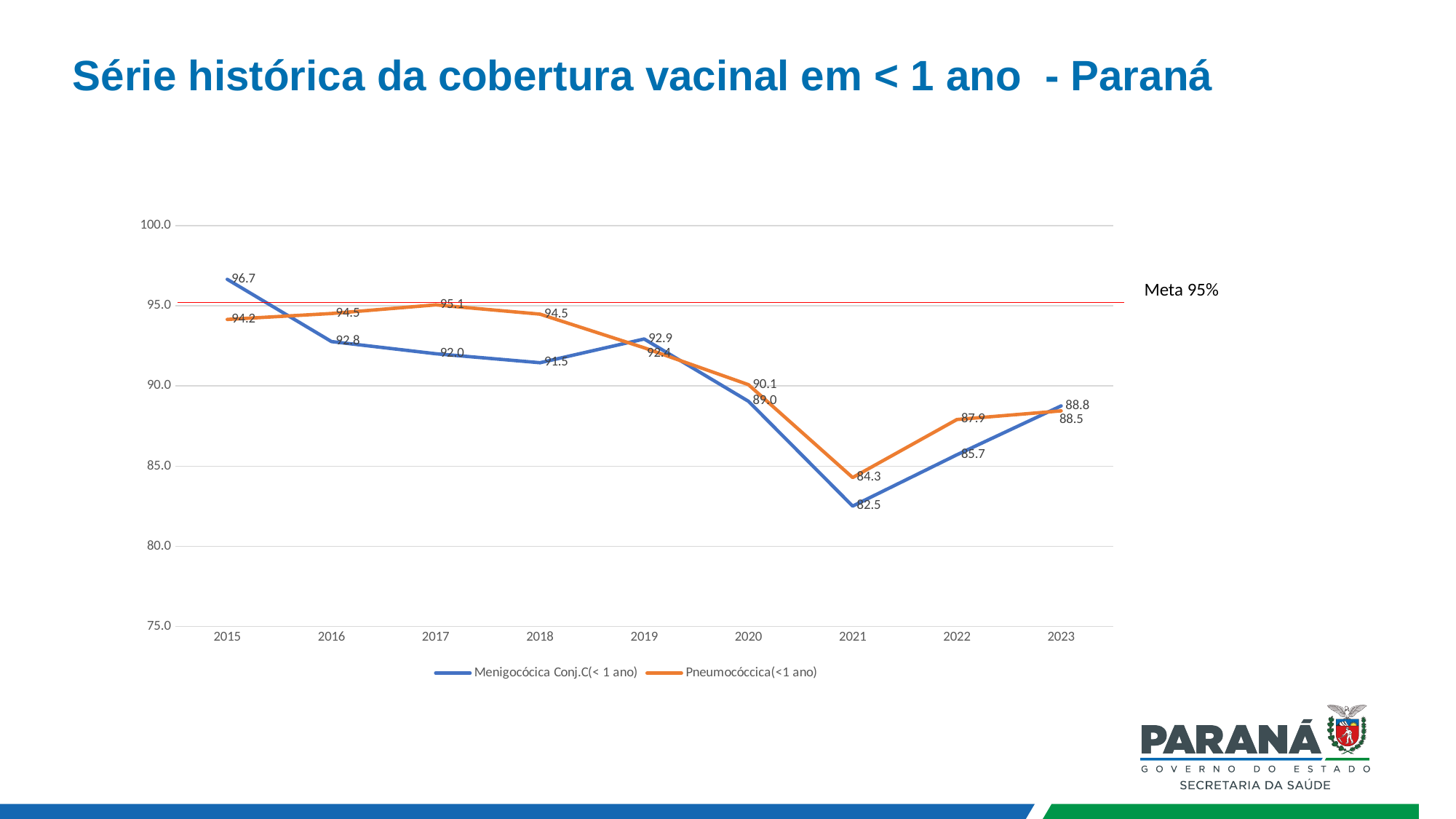
How many years are shown on the x axis? 9 What target (Meta) value is marked on the chart? 95% In which year is the Menigocócica Conj.C(< 1 ano) series at its lowest? 2021 What is the value for Menigocócica Conj.C(< 1 ano) in 2015? 96.7 What is the value for Pneumocóccica(<1 ano) in 2017? 95.1 What kind of chart is shown on the slide? Line chart What is the value for Menigocócica Conj.C(< 1 ano) in 2022? 85.7 How many series does the legend list? 2 Which series has the higher value in 2016, Menigocócica Conj.C(< 1 ano) or Pneumocóccica(<1 ano)? Pneumocóccica(<1 ano) In which year is the Pneumocóccica(<1 ano) series at its highest? 2017 What is the difference between the Pneumocóccica(<1 ano) and Menigocócica Conj.C(< 1 ano) values in 2021? 1.8 Does the Menigocócica Conj.C(< 1 ano) series rise or fall from 2015 to 2018? Fall